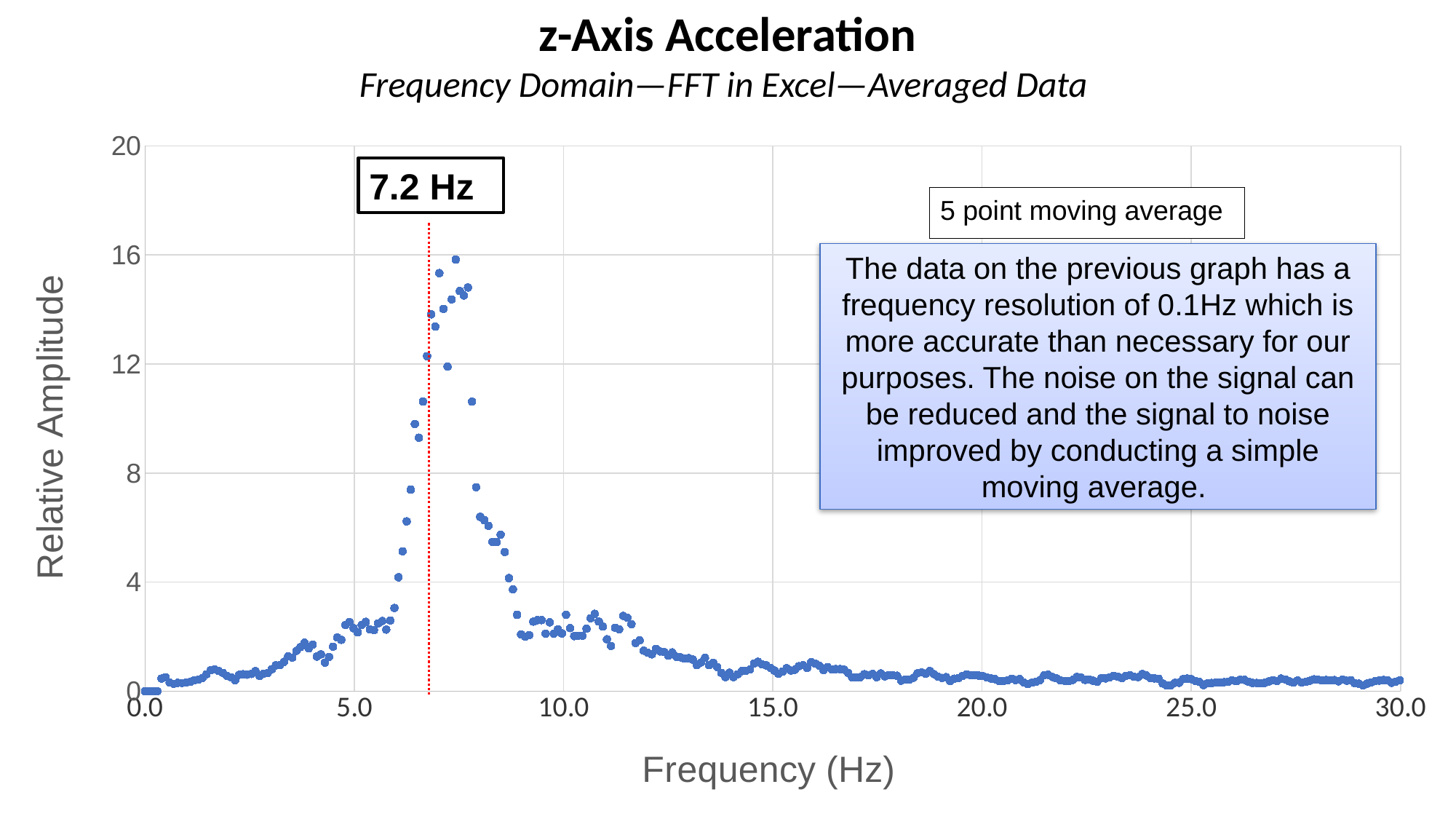
Do the relative amplitude values generally rise or fall as frequency increases from 10.0 Hz to 30.0 Hz? fall Is the relative amplitude at 7.2 Hz greater or less than 16? less At what frequency does the annotated peak of the chart occur? 7.2 Hz What is the maximum value shown on the y axis? 20 Is the highest relative amplitude on the chart greater or less than 12? greater What is the maximum frequency shown on the x axis? 30.0 What is the title of the chart? z-Axis Acceleration What kind of chart is shown on the slide? Scatter plot Is the relative amplitude at 20.0 Hz greater or less than 4? less Which has the larger relative amplitude: the point near 7.2 Hz or the point near 15.0 Hz? 7.2 Hz What is the label of the x axis? Frequency (Hz)